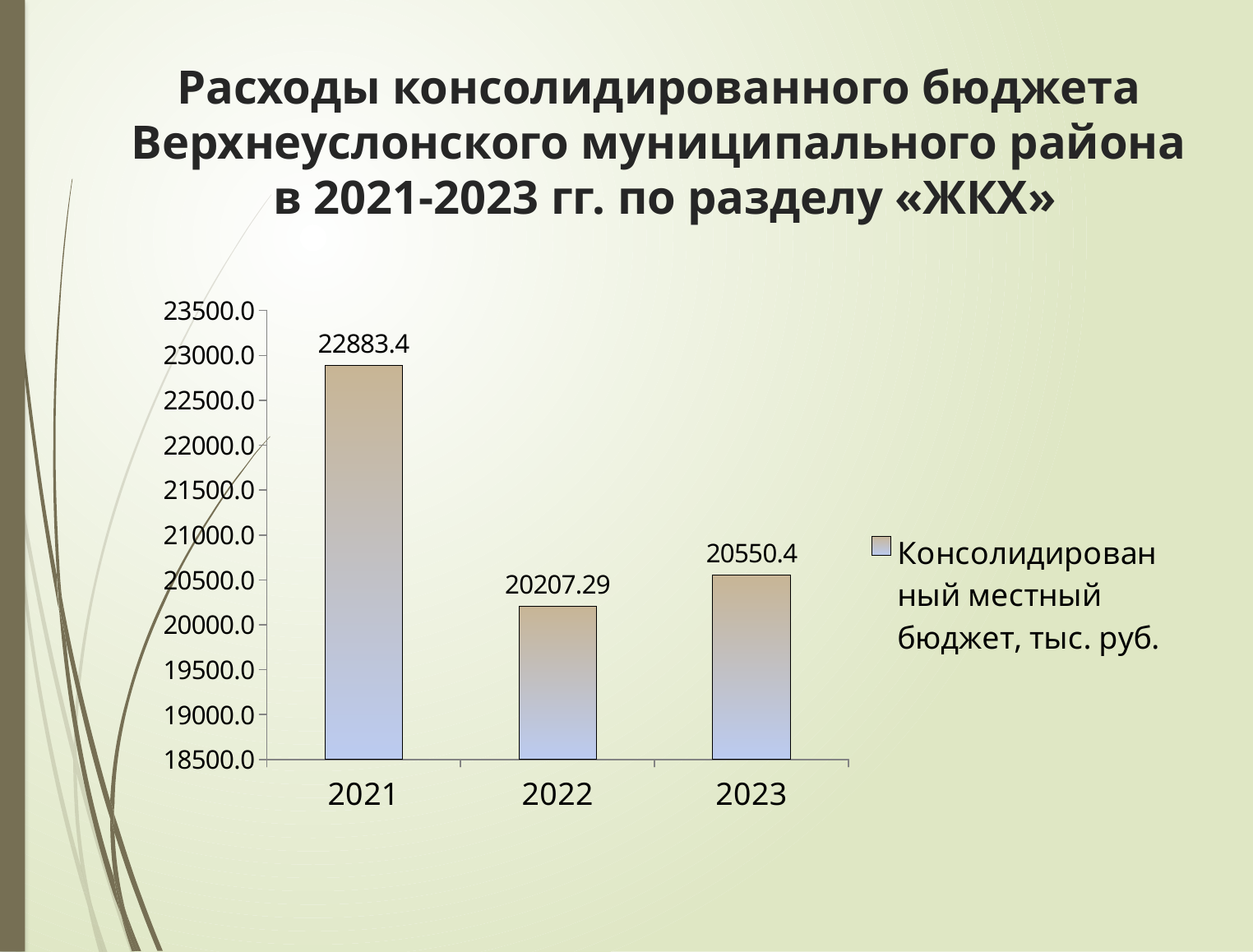
Каково значение консолидированного местного бюджета за 2022 год? 20207.29 Как называется ряд данных в легенде диаграммы? Консолидированный местный бюджет, тыс. руб. Какого типа эта диаграмма? Столбчатая (bar chart) Каково значение консолидированного местного бюджета за 2023 год? 20550.4 В каком году расходы по разделу «ЖКХ» были наименьшими? 2022 Какой год имеет большее значение: 2022 или 2023? 2023 На сколько расходы в 2023 году больше расходов в 2022 году? 343.11 Значение за 2021 год больше или меньше 22500.0? больше Каково значение консолидированного местного бюджета за 2021 год? 22883.4 Сколько лет (категорий) показано на диаграмме? 3 В каком году расходы по разделу «ЖКХ» были наибольшими? 2021 На сколько расходы в 2021 году превышают расходы в 2022 году? 2676.11